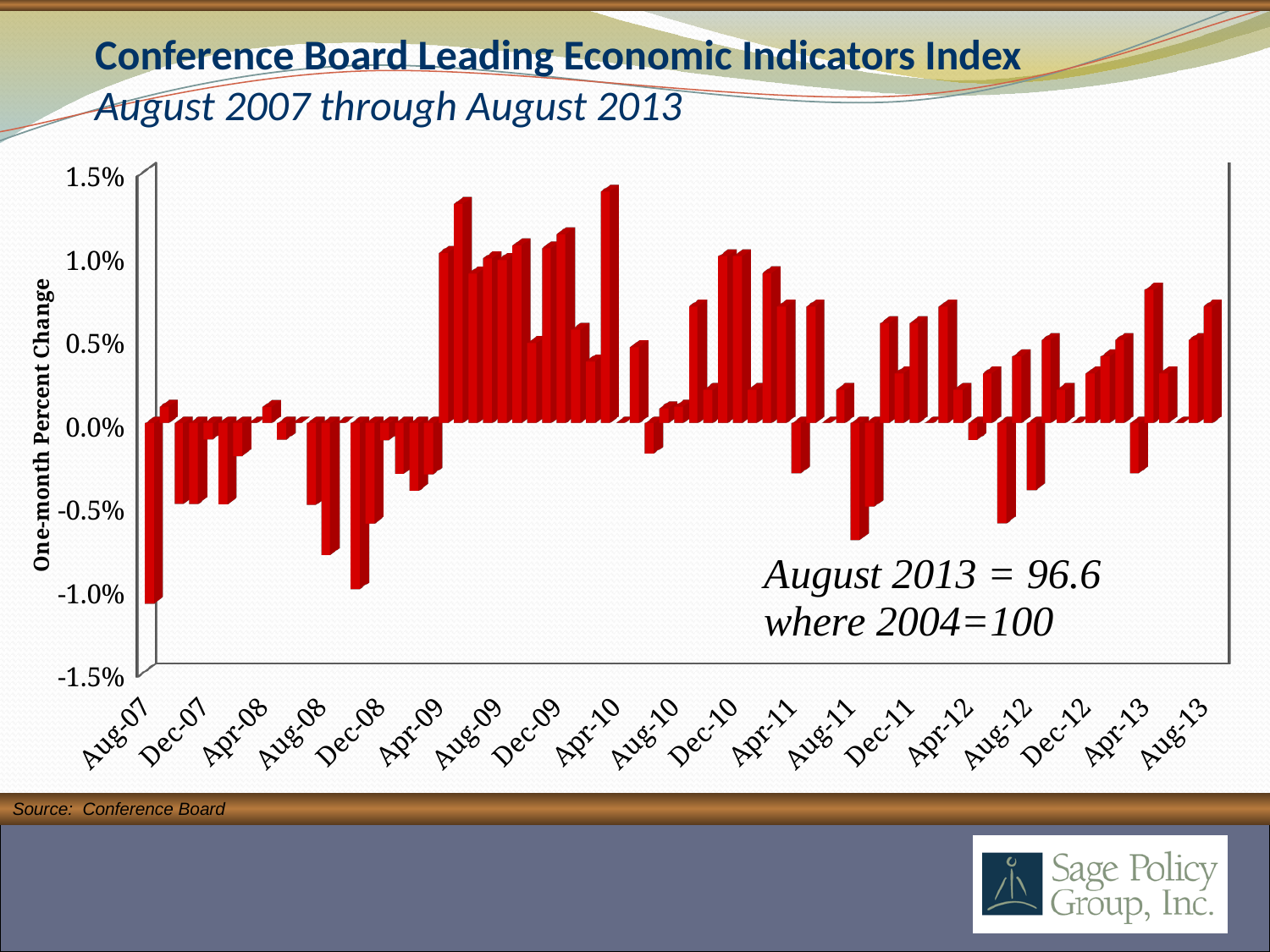
Is the value for Aug-13 greater or less than 0.5%? greater Are the bars from Aug-07 through Dec-08 mostly positive or mostly negative? mostly negative What kind of chart is shown on the slide? Bar chart Is the value for Aug-09 greater or less than 0.5%? greater What is the highest value shown on the vertical axis? 1.5% Is the value for Aug-07 greater or less than -0.5%? less According to the annotation on the chart, what was the index value in August 2013? 96.6 What is the title of the chart? Conference Board Leading Economic Indicators Index Which is larger, the value for Aug-07 or the value for Aug-13? Aug-13 What is the lowest value shown on the vertical axis? -1.5%